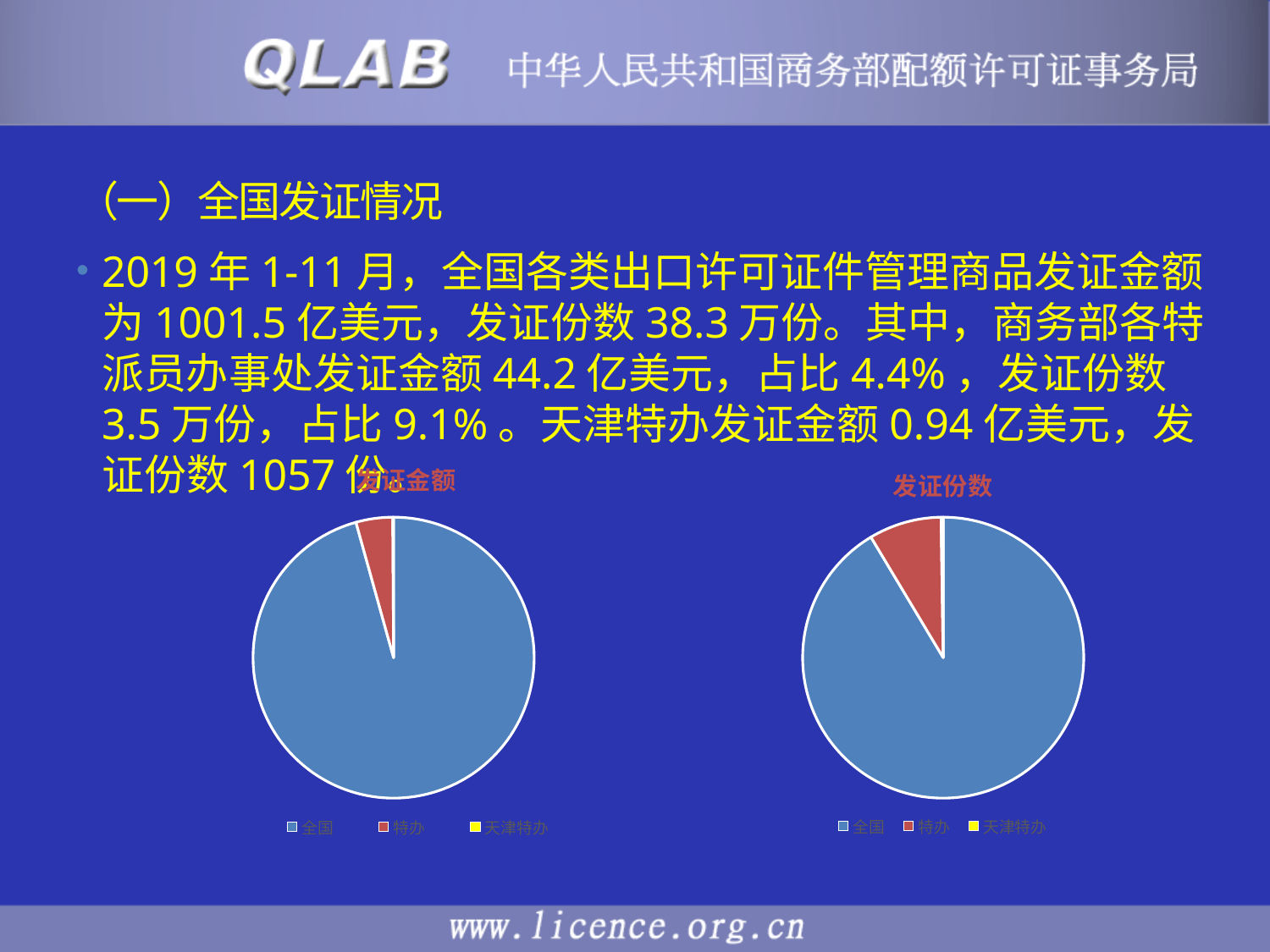
How many entries does the legend of the right chart (发证份数) list? 3 What kind of chart is the right chart titled 发证份数? pie chart Is the 特办 slice larger in the left chart (发证金额) or in the right chart (发证份数)? right chart (发证份数) In the left chart (发证金额), which category has the largest slice? 全国 What is the title of the right pie chart? 发证份数 How many entries does the legend of the left chart (发证金额) list? 3 In the left chart (发证金额), is the 全国 slice larger or smaller than the 特办 slice? larger In the left chart (发证金额), what colour is the 特办 slice? red In the left chart (发证金额), which of the visible slices is smaller, 全国 or 特办? 特办 In the right chart (发证份数), which of the visible slices is smaller, 全国 or 特办? 特办 In the right chart (发证份数), which category has the largest slice? 全国 What kind of chart is the left chart titled 发证金额? pie chart